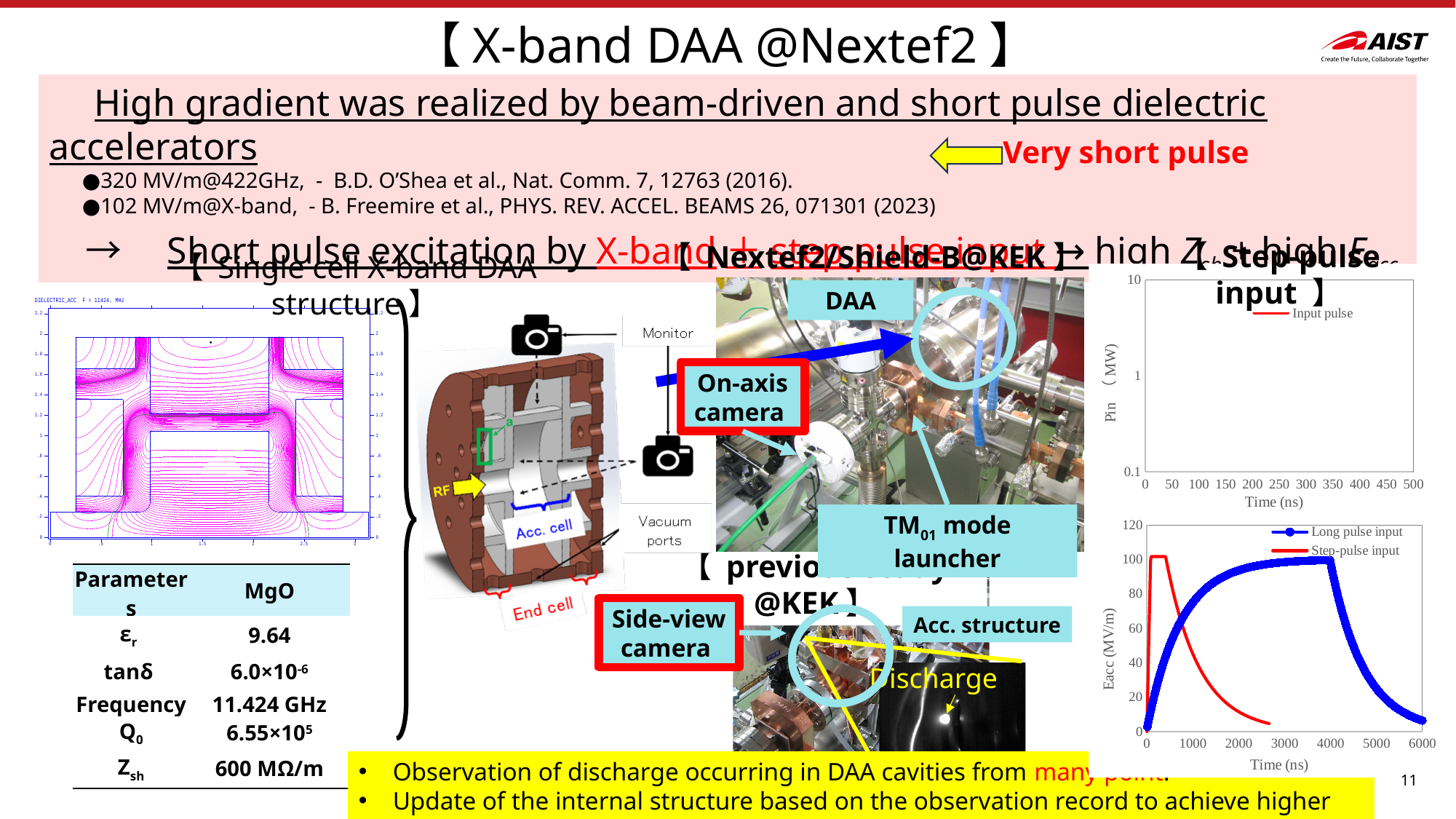
What is the maximum value shown on the Time (ns) axis of the top-right Pin (MW) chart? 500 In the bottom-right Eacc chart, does the Long pulse input curve rise or fall between 0 and 4000 ns? rise In the bottom-right Eacc chart, is the Long pulse input value at 2000 ns greater or less than 80? greater In the bottom-right Eacc chart, which series reaches its peak earlier in time, Long pulse input or Step-pulse input? Step-pulse input How many series does the legend of the top-right Step-pulse input chart (Pin vs Time) list? 1 What kind of chart is the bottom-right chart with Eacc (MV/m) on the vertical axis? line chart In the bottom-right Eacc chart, is the Long pulse input value at 5000 ns greater or less than 80? less In the bottom-right Eacc chart, which series is drawn in red? Step-pulse input In the bottom-right Eacc chart, is the Step-pulse input value at 2000 ns greater or less than 40? less How many series does the legend of the bottom-right Eacc chart list? 2 In the bottom-right Eacc chart, does the Step-pulse input curve rise or fall between 500 ns and 2500 ns? fall